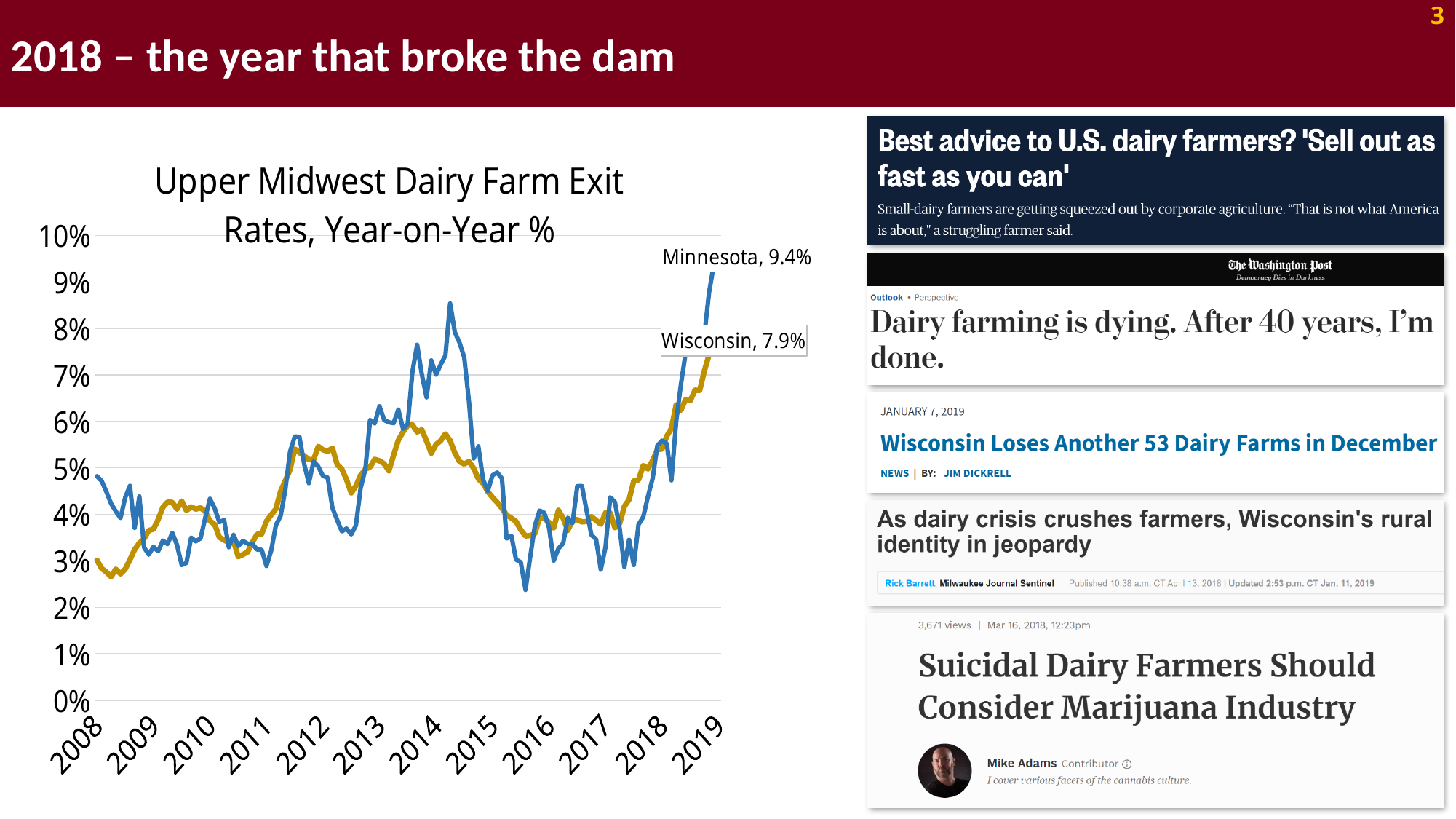
Which series has the higher labelled final value, Minnesota or Wisconsin? Minnesota How many year labels are shown on the x axis? 12 Do the exit rates for both states rise or fall between 2017 and 2019? rise What is the title of the chart? Upper Midwest Dairy Farm Exit Rates, Year-on-Year % Is the peak of the Minnesota line around 2014 greater or less than 8%? greater What is the labelled final value for Minnesota? 9.4% Which series reaches the highest value on the chart? Minnesota What kind of chart is shown on the slide? line chart What is the difference between the labelled final values for Minnesota and Wisconsin? 1.5% What is the labelled final value for Wisconsin? 7.9% How many series are plotted on the chart? 2 Is the lowest point of the Minnesota line, around 2016, greater or less than 3%? less